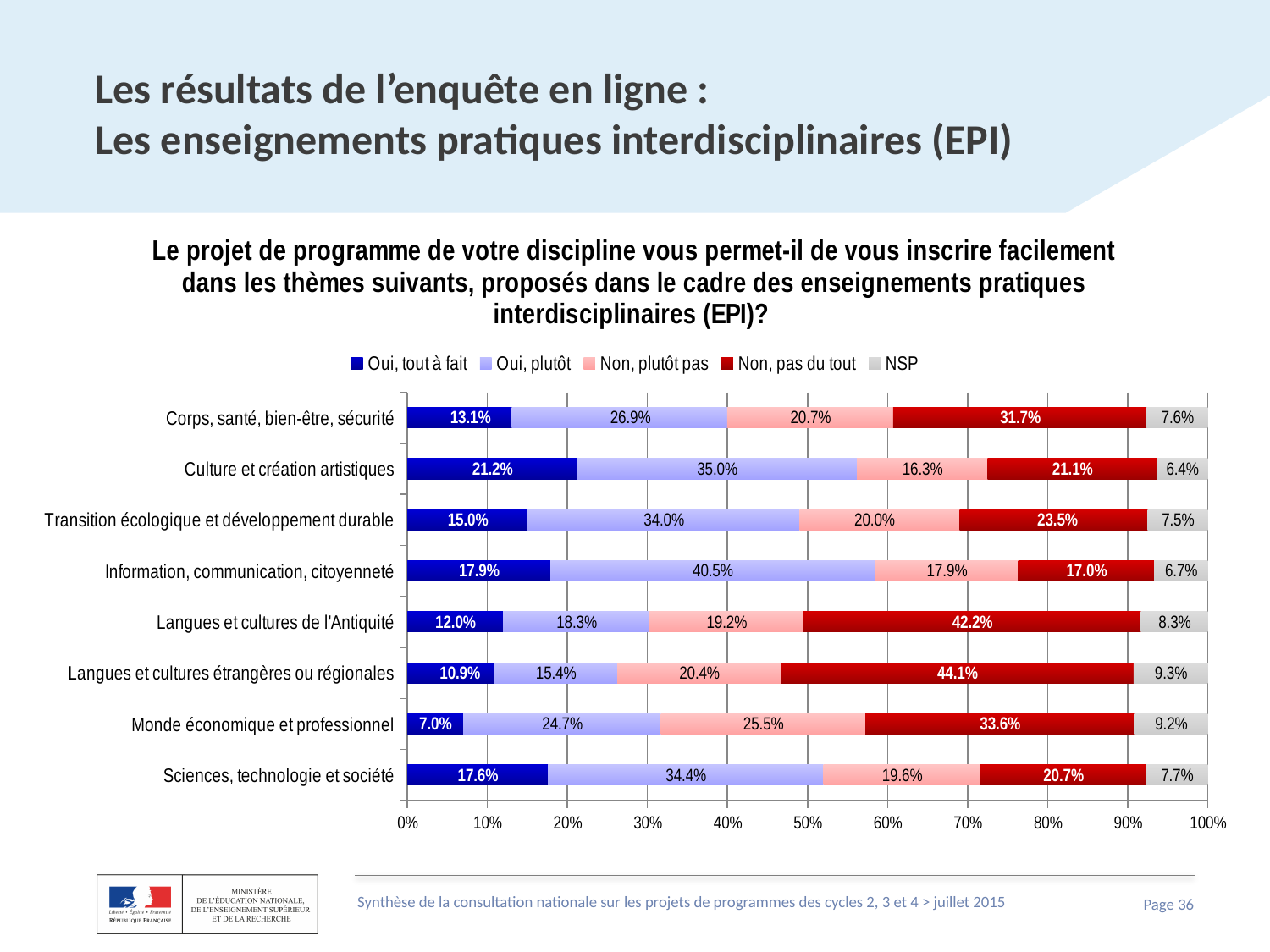
What percentage of respondents answered "Oui, tout à fait" for "Culture et création artistiques"? 21.2% What is the combined "Oui, tout à fait" and "Oui, plutôt" share for "Information, communication, citoyenneté"? 58.4% Which theme has the highest "Non, pas du tout" value? Langues et cultures étrangères ou régionales Which theme has the highest "Oui, plutôt" value? Information, communication, citoyenneté What kind of chart is shown on the slide? Stacked bar chart Which has the larger "Non, plutôt pas" value: "Monde économique et professionnel" or "Culture et création artistiques"? Monde économique et professionnel How many series does the legend list? 5 What is the NSP value for "Sciences, technologie et société"? 7.7% What is the difference in "Non, pas du tout" values between "Langues et cultures étrangères ou régionales" and "Corps, santé, bien-être, sécurité"? 12.4 percentage points How many themes (categories) are shown in the chart? 8 What is the "Non, pas du tout" value for "Langues et cultures de l'Antiquité"? 42.2% Which theme has the lowest "Oui, tout à fait" value? Monde économique et professionnel